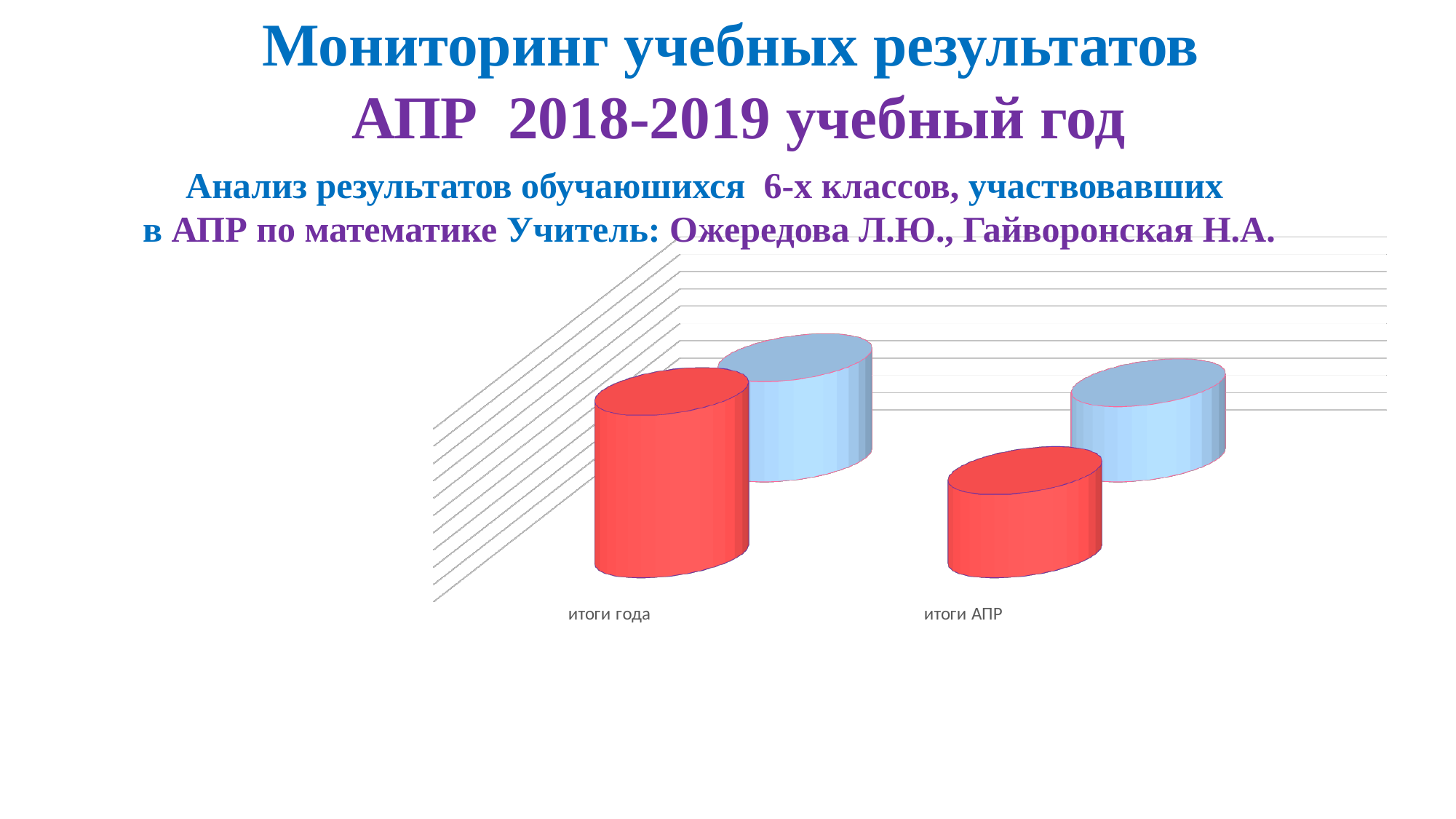
Which category has the taller blue bar, итоги года or итоги АПР? итоги года Does the blue series rise or fall from итоги года to итоги АПР? fall Does the red series rise or fall from итоги года to итоги АПР? fall Which category has the taller red bar, итоги года or итоги АПР? итоги года How many categories are shown on the x axis of the chart? 2 What are the two category labels on the x axis of the chart? итоги года, итоги АПР Which category has the lowest red bar? итоги АПР What kind of chart is shown on the slide? bar chart What two colours are used for the bars in the chart? red and blue